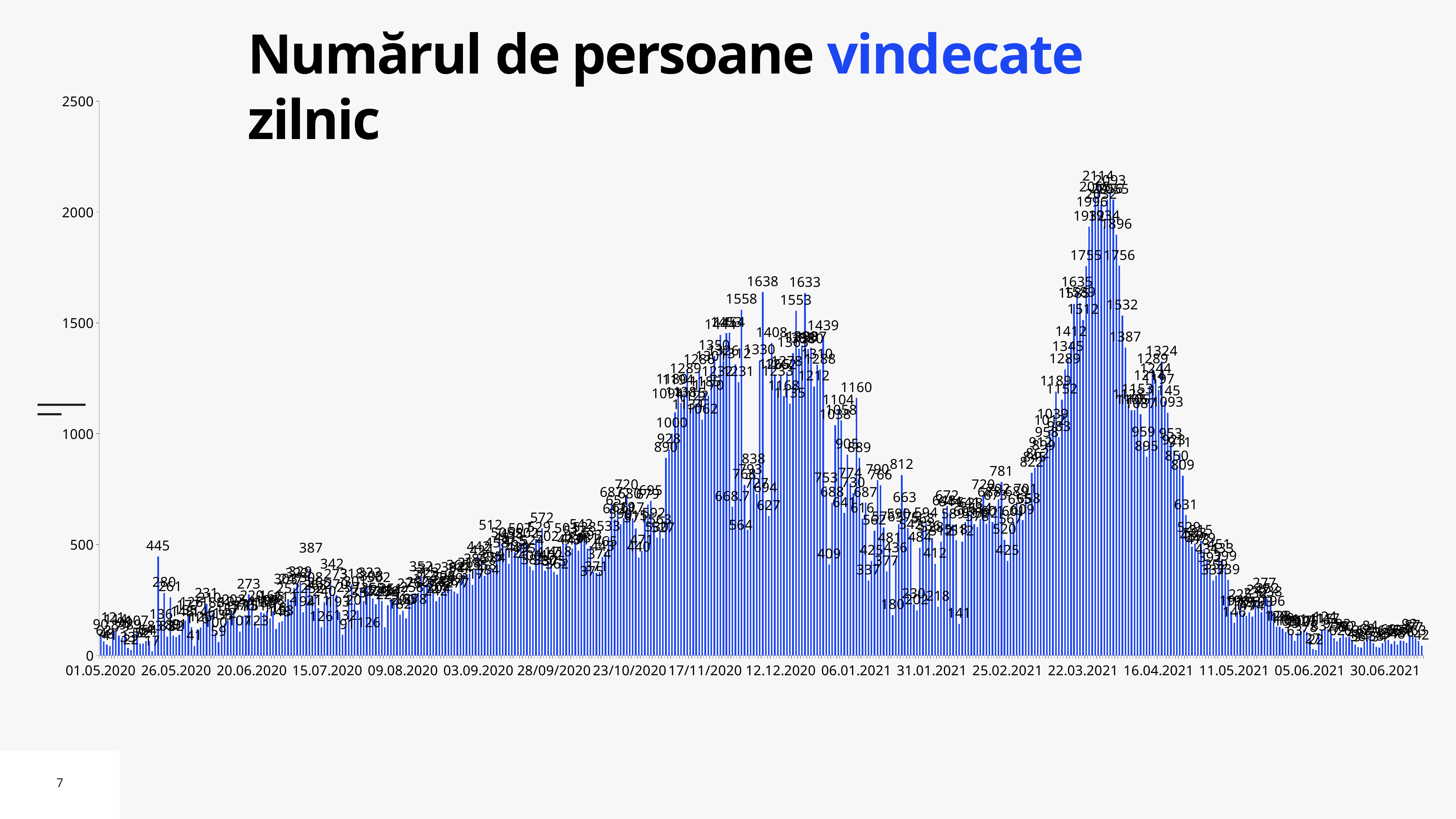
Which peak is higher: the one around 12.12.2020 or the one around 22.03.2021? the one around 22.03.2021 Do the values rise or fall between 25.02.2021 and 22.03.2021? rise Is the value at 01.05.2020 greater or less than 500? less What is the first date shown on the horizontal axis? 01.05.2020 Is the value at 30.06.2021 greater or less than 500? less What is the maximum value shown on the vertical axis? 2500 What is the title of the chart? Numărul de persoane vindecate zilnic What kind of chart is shown on the slide? bar chart How many date labels are shown on the horizontal axis? 18 What is the highest value labeled on the chart? 2114 Do the values rise or fall between 16.04.2021 and 05.06.2021? fall